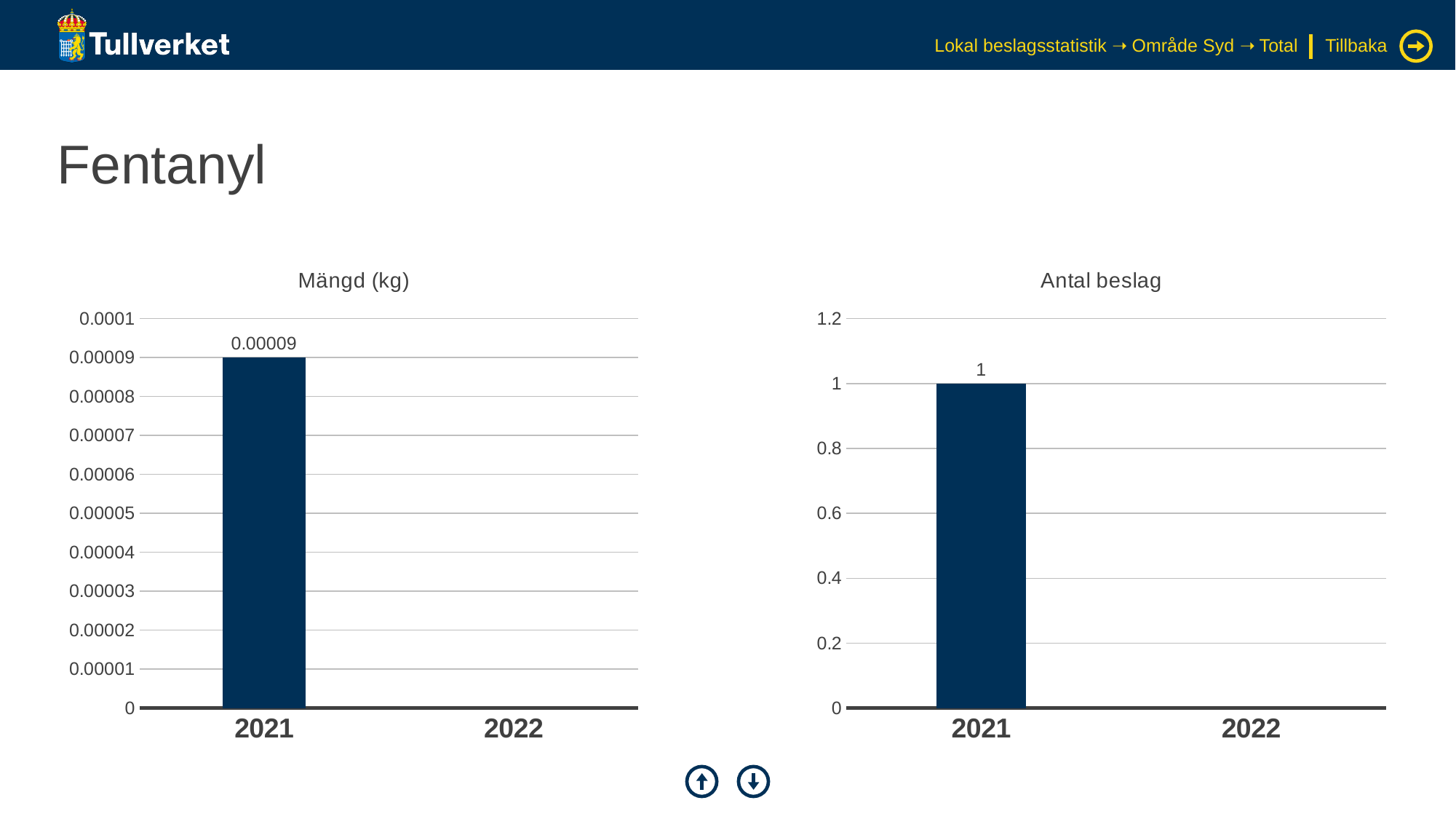
In the "Mängd (kg)" chart, which year has the highest value? 2021 What is the title of the chart on the left side of the slide? Mängd (kg) In the "Antal beslag" chart, is the value for 2021 greater or less than 0.8? greater In the "Antal beslag" chart, what is the value for 2021? 1 What kind of chart is the "Antal beslag" chart? Bar chart In the "Antal beslag" chart, which year has the highest value? 2021 In the "Mängd (kg)" chart, is the value for 2021 greater or less than 0.00005? greater In the "Mängd (kg)" chart, what is the value for 2021? 0.00009 How many years are shown on the x axis of the "Mängd (kg)" chart? 2